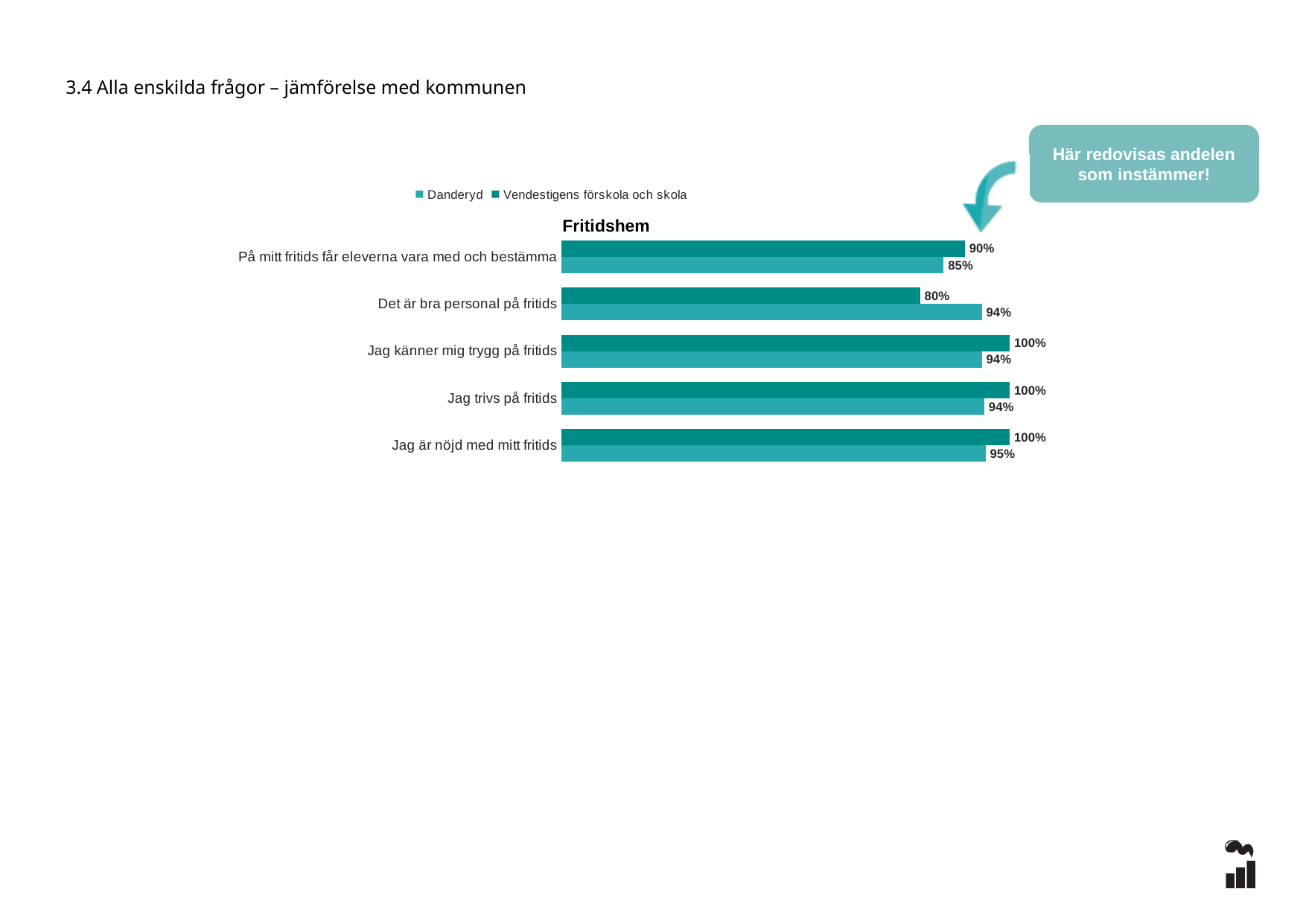
What is the difference between Vendestigens förskola och skola and Danderyd on "Jag känner mig trygg på fritids"? 6 percentage points What is the value for Vendestigens förskola och skola on "Jag trivs på fritids"? 100% How many questions (categories) are shown in the chart? 5 What is the value for Vendestigens förskola och skola on "Det är bra personal på fritids"? 80% What is the value for Danderyd on "Jag är nöjd med mitt fritids"? 95% Which question has the lowest value for Danderyd? På mitt fritids får eleverna vara med och bestämma What is the value for Danderyd on "På mitt fritids får eleverna vara med och bestämma"? 85% What is the difference between Danderyd and Vendestigens förskola och skola on "Det är bra personal på fritids"? 14 percentage points How many series does the legend list? 2 What type of chart is shown on the slide? Bar chart On "På mitt fritids får eleverna vara med och bestämma", which is higher: Danderyd or Vendestigens förskola och skola? Vendestigens förskola och skola Which question has the lowest value for Vendestigens förskola och skola? Det är bra personal på fritids